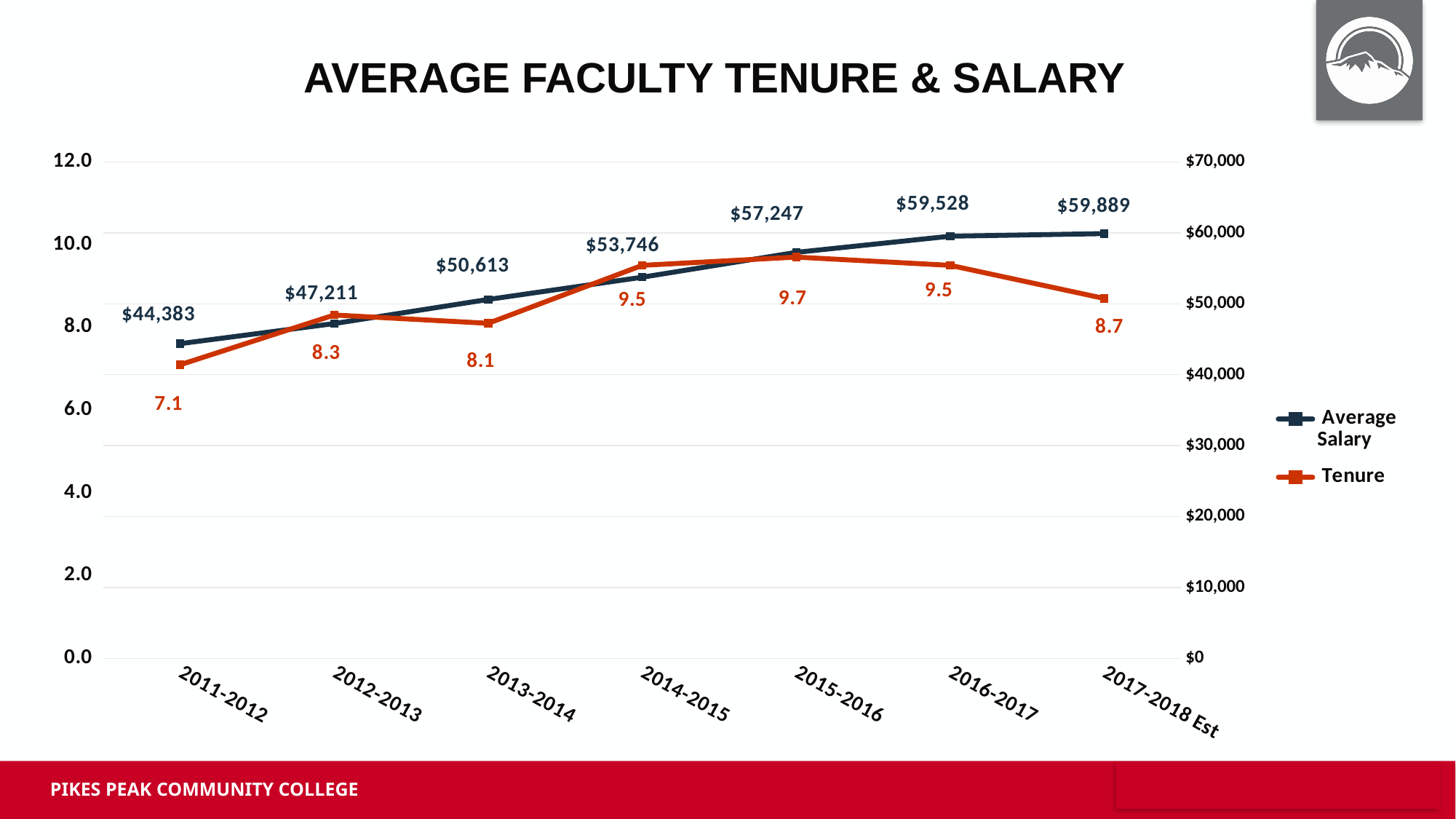
Is the Average Salary for 2015-2016 greater or less than $50,000? greater Which year has the highest Average Salary? 2017-2018 Est What kind of chart is shown on the slide? Line chart Which year has the lowest Tenure value? 2011-2012 What is the difference between the highest and lowest Tenure values? 2.6 What is the Average Salary for 2017-2018 Est? $59,889 What is the Tenure value for 2015-2016? 9.7 What is the difference in Average Salary between 2017-2018 Est and 2011-2012? $15,506 How many series does the legend list? 2 How many academic years are shown on the x axis? 7 Which is larger, the Tenure value for 2012-2013 or for 2013-2014? 2012-2013 What is the Average Salary for 2013-2014? $50,613